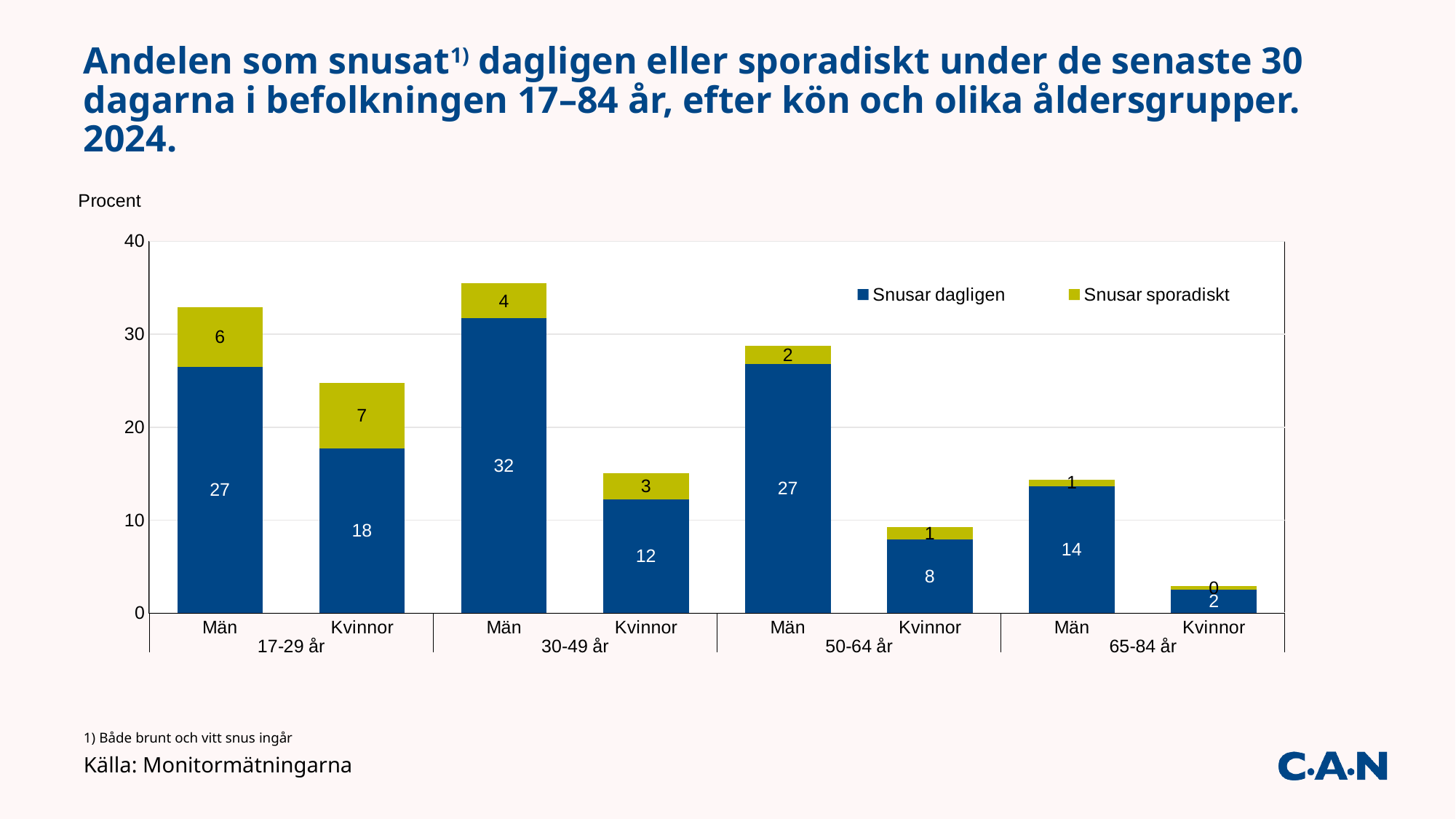
What is the difference between the 'Snusar dagligen' values for Män and Kvinnor aged 50-64 år? 19 What kind of chart is shown on the slide? Stacked bar chart How many series does the legend list? 2 What is the value for 'Snusar sporadiskt' for Kvinnor aged 17-29 år? 7 Which group has the highest value for 'Snusar dagligen'? Män 30-49 år Is the total stacked bar for Män aged 17-29 år greater or less than 30? greater What is the value for 'Snusar dagligen' for Kvinnor aged 65-84 år? 2 What is the total of the stacked bar for Kvinnor aged 30-49 år, based on the printed labels? 15 Which group has the lowest value for 'Snusar sporadiskt'? Kvinnor 65-84 år What is the value for 'Snusar dagligen' for Män aged 30-49 år? 32 How many bars are plotted in the chart? 8 Which is larger: the 'Snusar dagligen' value for Kvinnor 17-29 år or for Män 65-84 år? Kvinnor 17-29 år